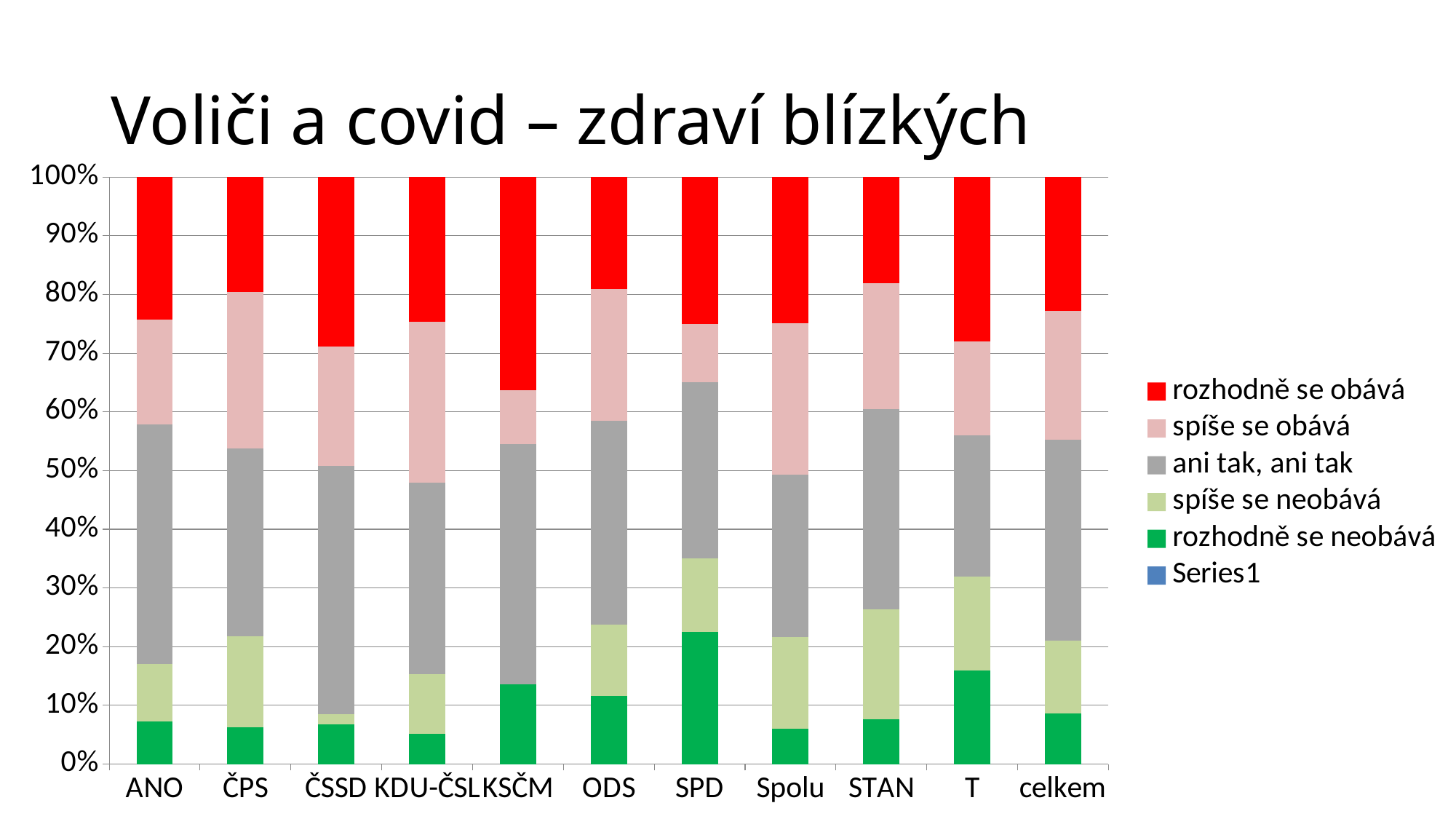
Which has a larger 'rozhodně se obává' segment, KSČM or ANO? KSČM Which category has the largest 'rozhodně se obává' (red) segment? KSČM What is the title of the chart? Voliči a covid – zdraví blízkých How many categories (voter groups) are shown along the x axis? 11 Which category has the largest 'rozhodně se neobává' (dark green) segment? SPD Is the 'rozhodně se neobává' value for KSČM greater or less than 10%? greater How many series does the legend list? 6 What kind of chart is shown on the slide? stacked bar chart Is the 'rozhodně se neobává' value for SPD greater or less than 20%? greater Which has a larger 'rozhodně se neobává' segment, SPD or T? SPD Is the 'rozhodně se neobává' value for ANO greater or less than 10%? less Which colour represents 'rozhodně se obává' in the chart? red